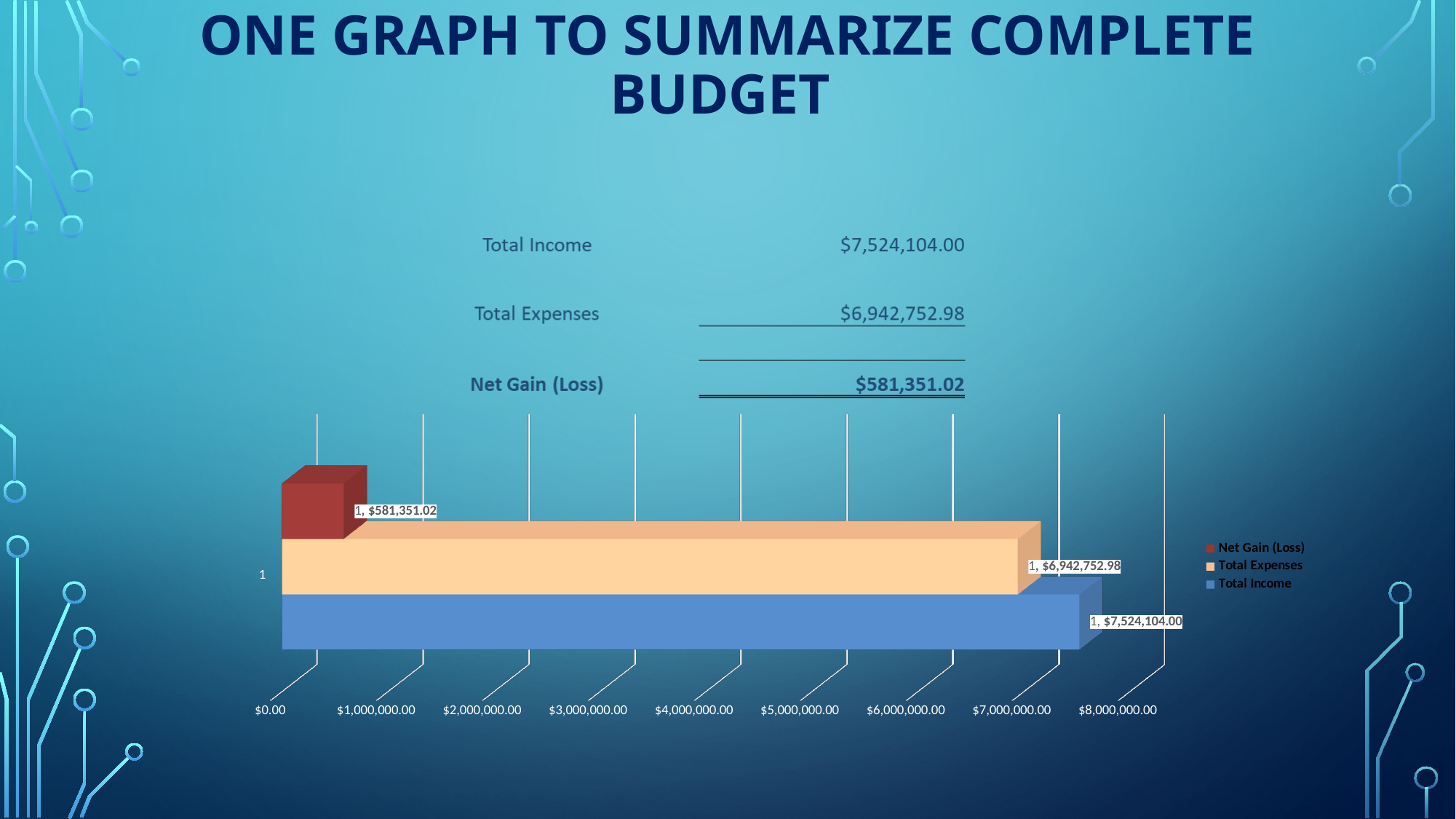
Which is larger, Total Expenses or Net Gain (Loss)? Total Expenses What is the value of the Total Expenses bar? $6,942,752.98 Is the value for Total Income greater or less than $7,000,000.00? greater What is the value of the Net Gain (Loss) bar? $581,351.02 Which series has the highest value? Total Income What is the value of the Total Income bar? $7,524,104.00 What kind of chart is shown on the slide? bar chart How many series does the legend list? 3 Is the value for Total Expenses greater or less than $7,000,000.00? less What colour is the Total Income bar? blue What is the difference between Total Income and Total Expenses? $581,351.02 Which series has the lowest value? Net Gain (Loss)